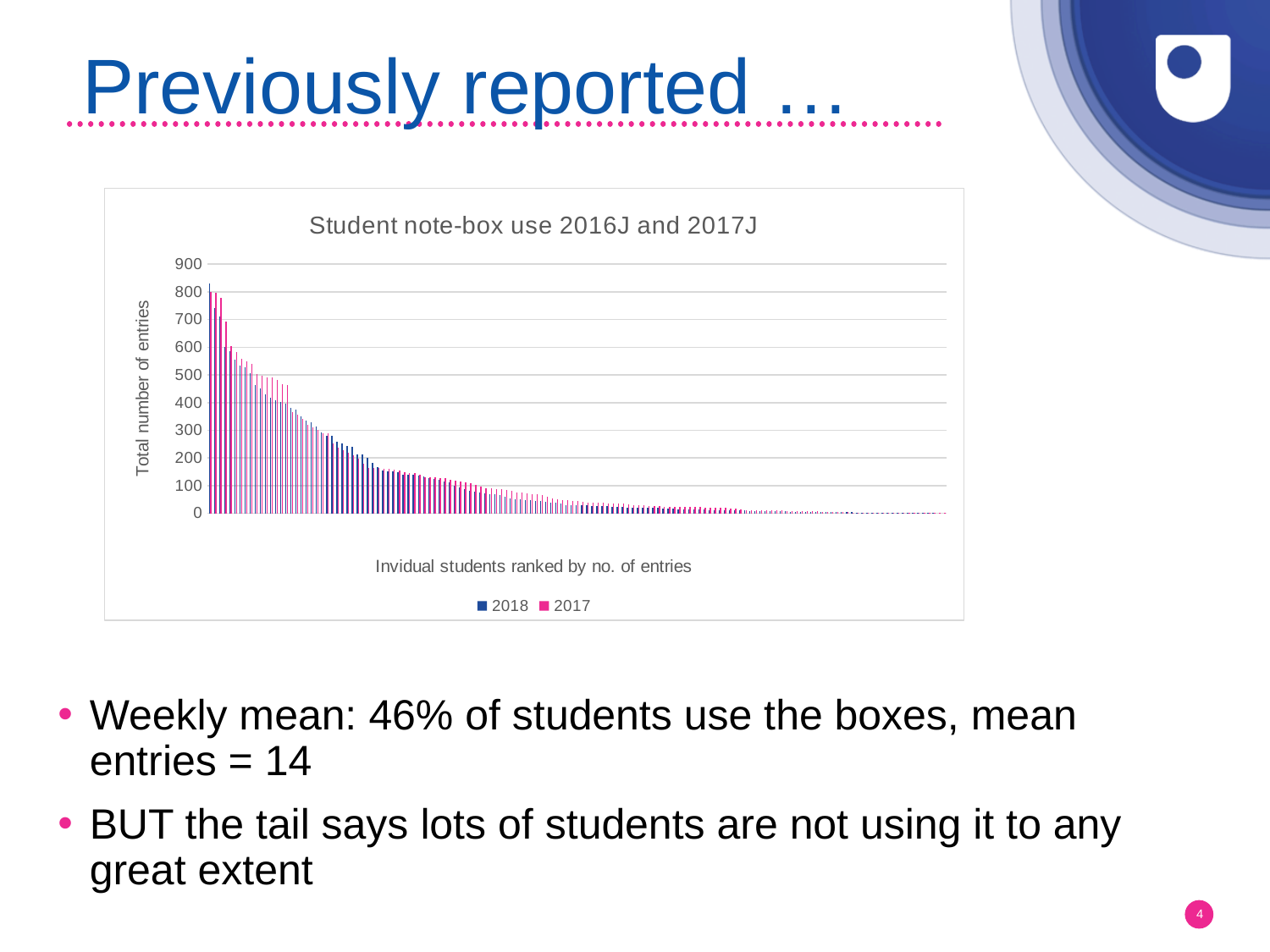
Do the bar values rise or fall moving from left to right along the x axis? Fall Is the value of the tallest bar in the chart greater or less than 700? greater What is the label of the y axis of the chart? Total number of entries What is the label of the x axis of the chart? Invidual students ranked by no. of entries Are the bars at the far right end of the chart greater or less than 100? less How many series does the legend of the chart list? 2 Is the value of the tallest bar in the chart greater or less than 900? less What is the title of the chart? Student note-box use 2016J and 2017J Which series is shown in pink in the chart? 2017 What is the highest value shown on the y axis of the chart? 900 What kind of chart is shown on the slide? Bar chart